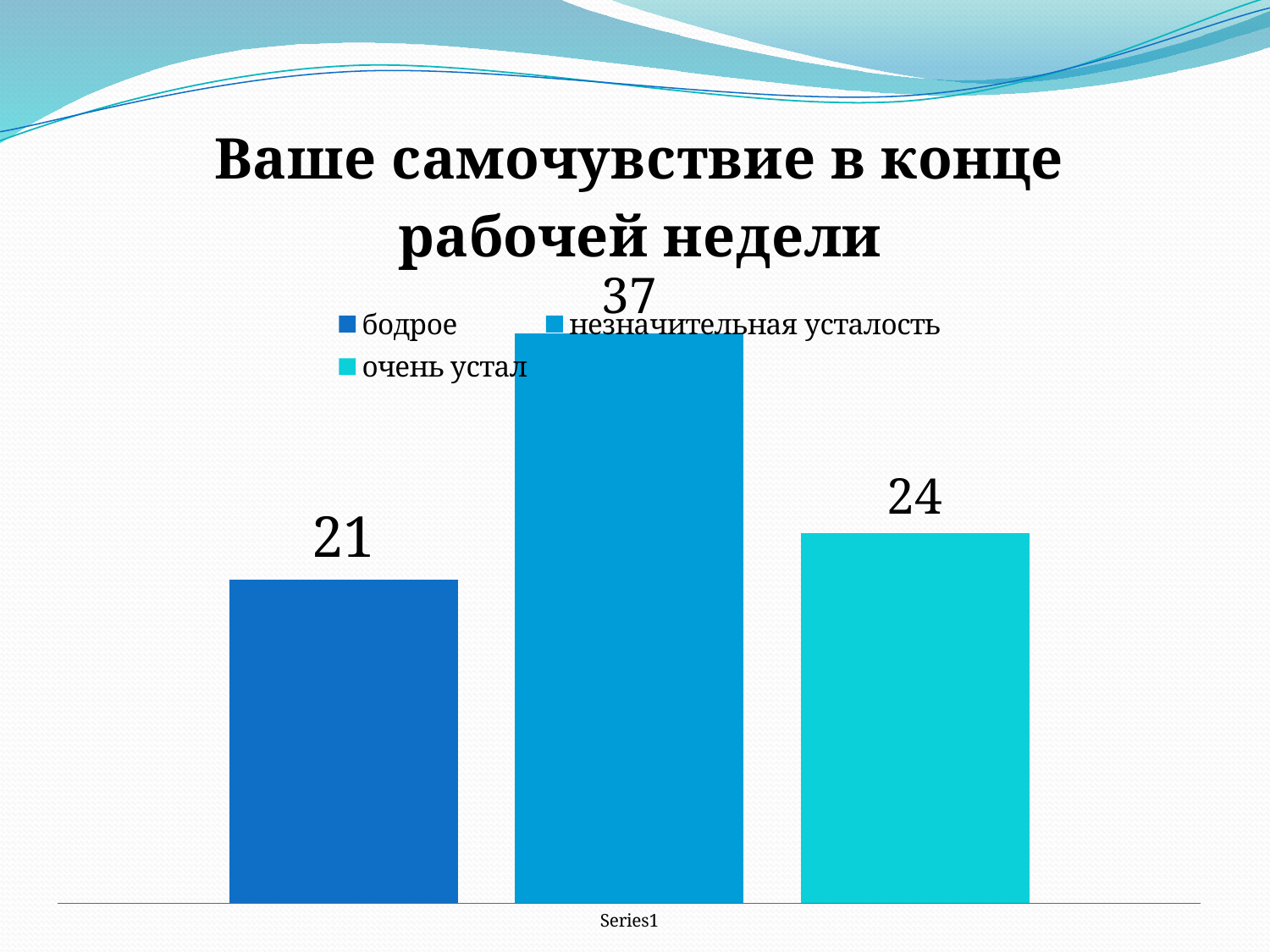
Which category has the lowest value? бодрое What is the difference between the values for "незначительная усталость" and "бодрое"? 16 What is the value for "незначительная усталость"? 37 Which category has the highest value? незначительная усталость What is the title of the chart? Ваше самочувствие в конце рабочей недели How many bars are shown in the chart? 3 What kind of chart is shown on the slide? bar chart How many entries does the legend list? 3 What is the value for "бодрое"? 21 What is the value for "очень устал"? 24 What is the difference between the values for "очень устал" and "бодрое"? 3 Which is larger, the value for "очень устал" or the value for "бодрое"? очень устал